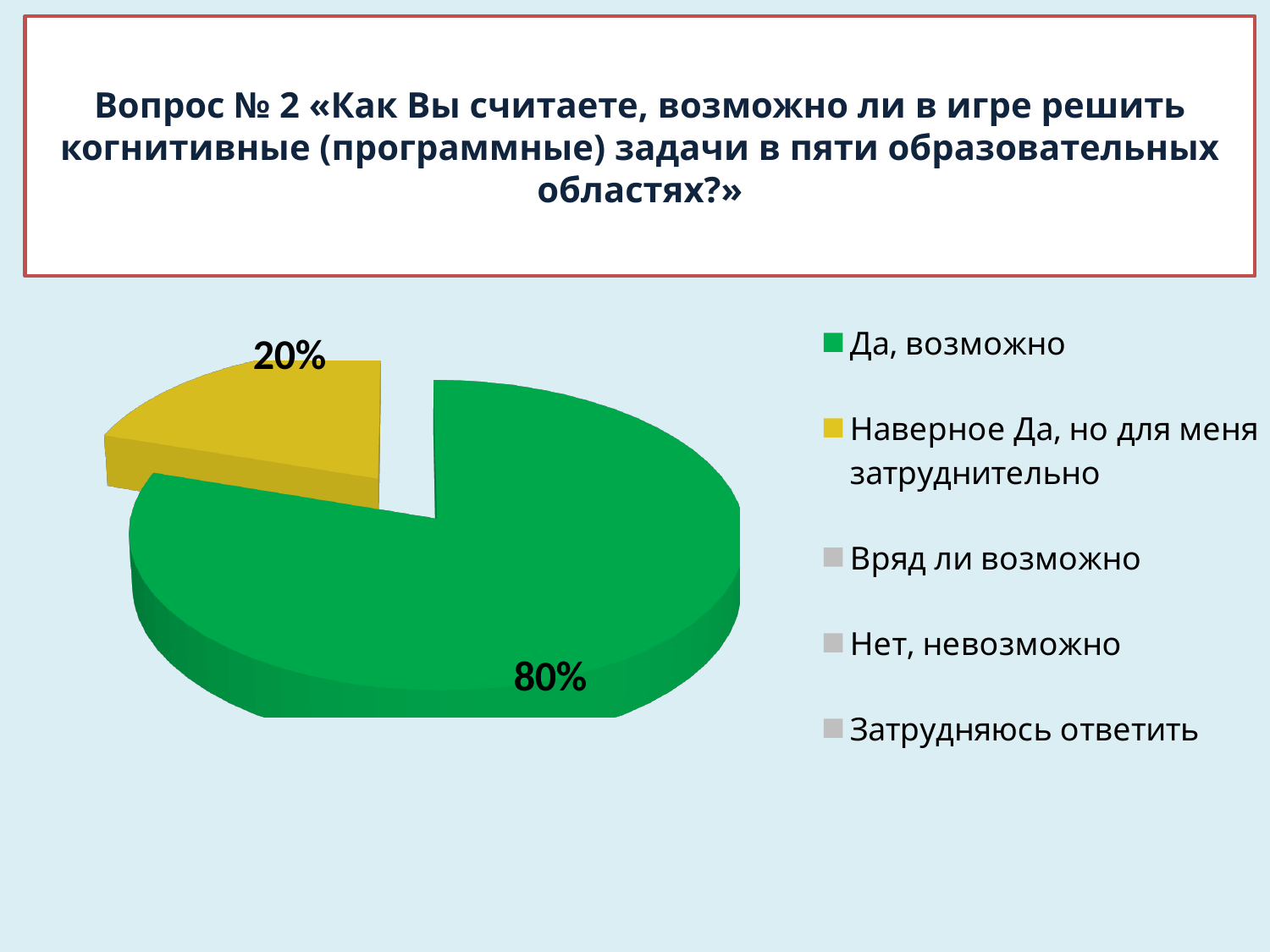
How many entries does the legend list? 5 What colour is the slice for "Наверное Да, но для меня затруднительно"? yellow Which of the two visible slices is larger: "Да, возможно" or "Наверное Да, но для меня затруднительно"? Да, возможно What share of the pie does "Да, возможно" take? 80% What colour is the slice for "Да, возможно"? green How many slices are visible in the pie? 2 What kind of chart is shown on the slide? pie chart What share of the pie does "Наверное Да, но для меня затруднительно" take? 20% Which category has the largest slice of the pie? Да, возможно What is the difference in percentage points between the "Да, возможно" slice and the "Наверное Да, но для меня затруднительно" slice? 60